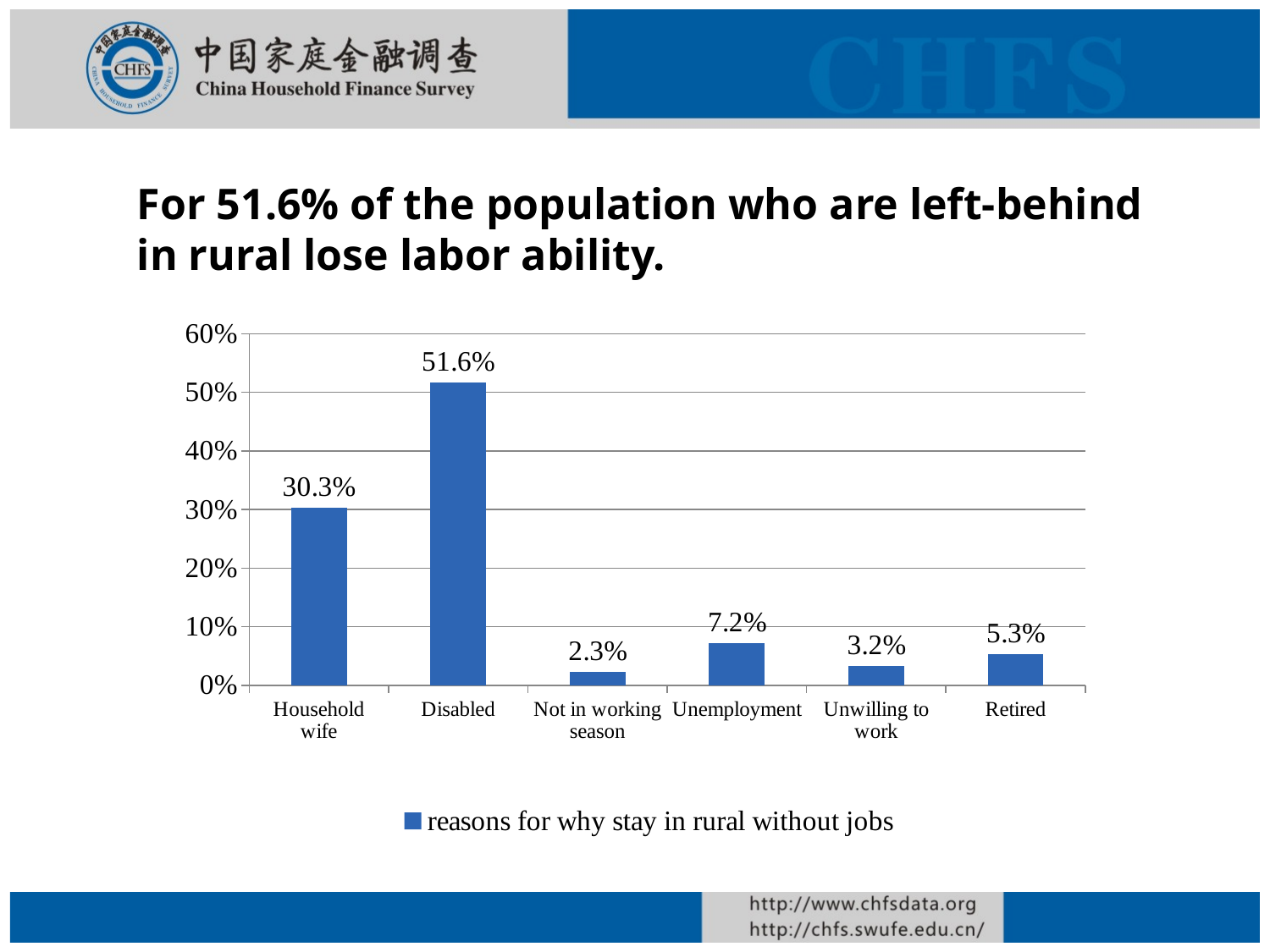
Which category has the lowest value? Not in working season What kind of chart is shown on the slide? bar chart Is the value for Household wife greater or less than 20%? greater What is the difference between the values for Disabled and Household wife? 21.3% What is the value for Household wife? 30.3% What is the value for Unemployment? 7.2% Which category has the highest value? Disabled Which is larger, the value for Unemployment or the value for Unwilling to work? Unemployment What is the legend entry for the series shown? reasons for why stay in rural without jobs What is the value for Retired? 5.3% What is the value for Disabled? 51.6% How many categories are shown on the x axis? 6